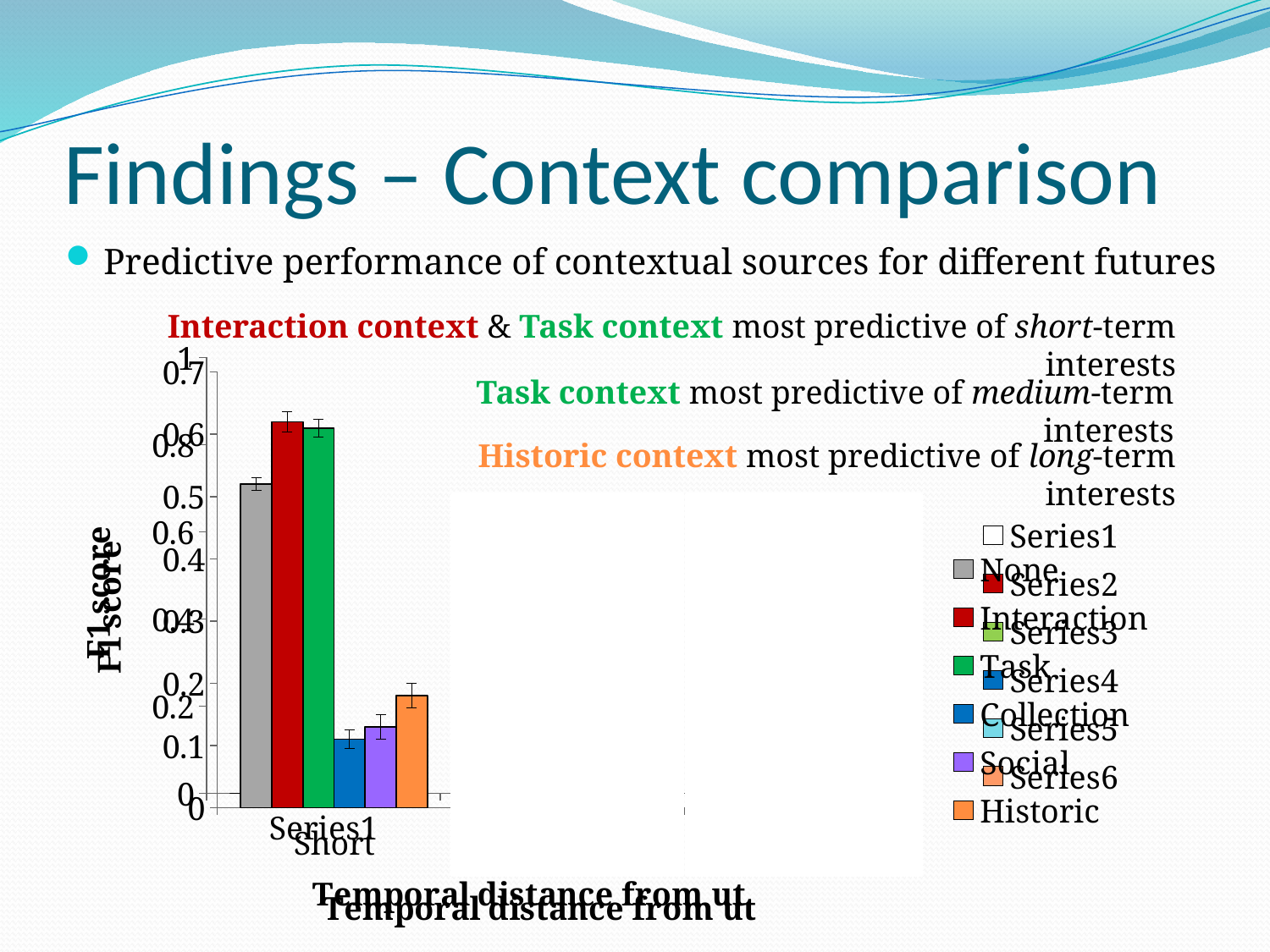
Is the value for Task in the Short category greater or less than 0.5? greater What is the title of the x axis of the chart? Temporal distance from ut What is the title of the y axis of the chart? F1 score Is the value for Collection in the Short category greater or less than 0.2? less What kind of chart is shown on the slide? bar chart Is the value for Historic in the Short category greater or less than 0.3? less In the Short category, which is larger, the value for Historic or the value for Social? Historic In the Short category, which is larger, the value for None or the value for Historic? None In the Short category, which is larger, the value for Interaction or the value for Collection? Interaction How many series does the chart legend list? 6